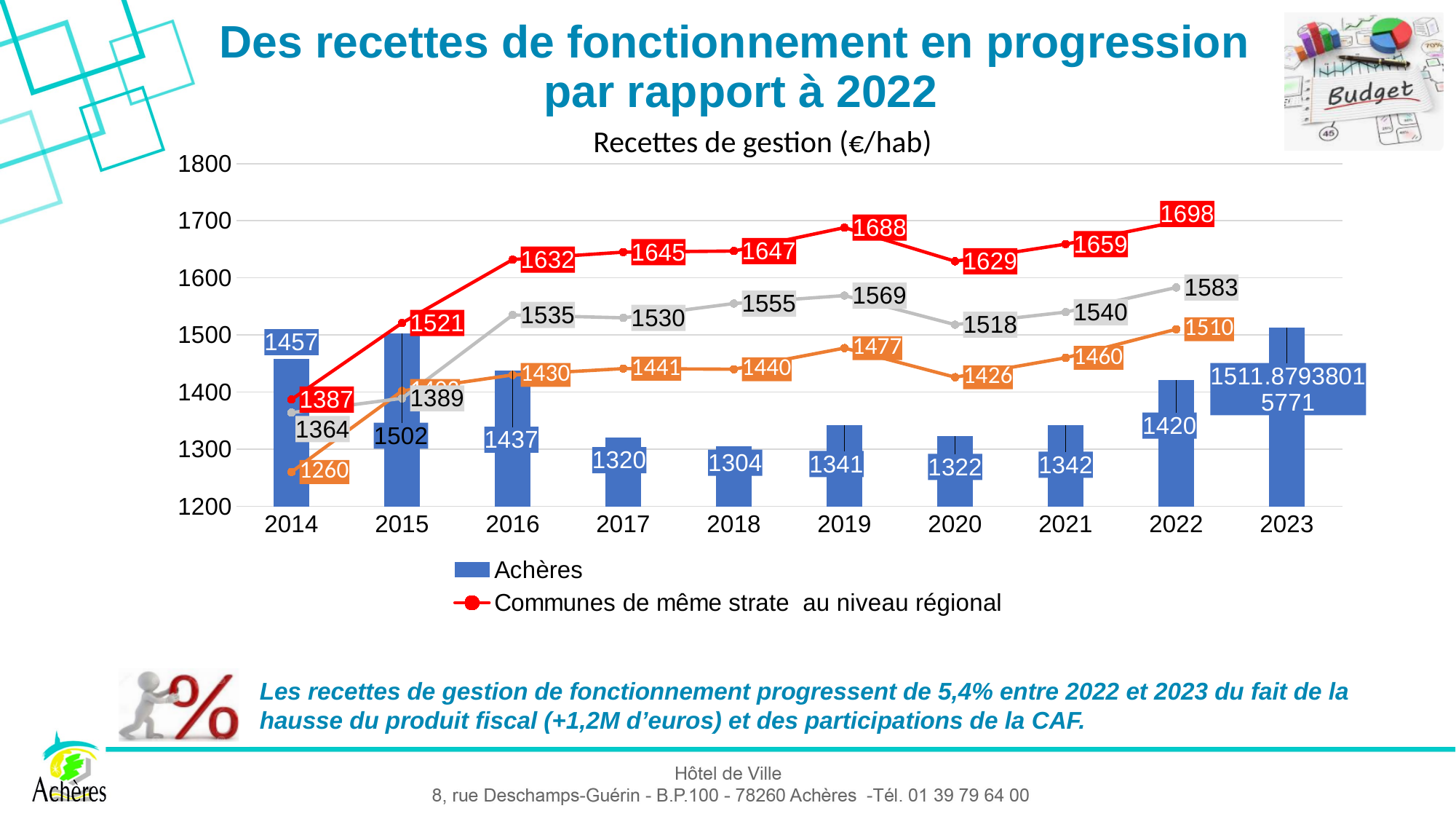
Which is larger, the Achères value for 2019 or for 2020? 2019 What kind of chart is shown on the slide? Combined bar and line chart Does the red 'Communes de même strate au niveau régional' line rise or fall from 2014 to 2016? Rise In which year is the Achères bar the lowest? 2018 How many series does the legend of the chart list? 2 In which year does the red 'Communes de même strate au niveau régional' line reach its highest value? 2022 How many years are shown on the x axis of the chart? 10 What is the value of the red 'Communes de même strate au niveau régional' line for 2022? 1698 What is the value of the Achères bar for 2022? 1420 Is the Achères value for 2023 greater or less than 1500? greater What is the difference between the Achères values for 2022 and 2021? 78 What is the value of the Achères bar for 2018 in the 'Recettes de gestion (€/hab)' chart? 1304